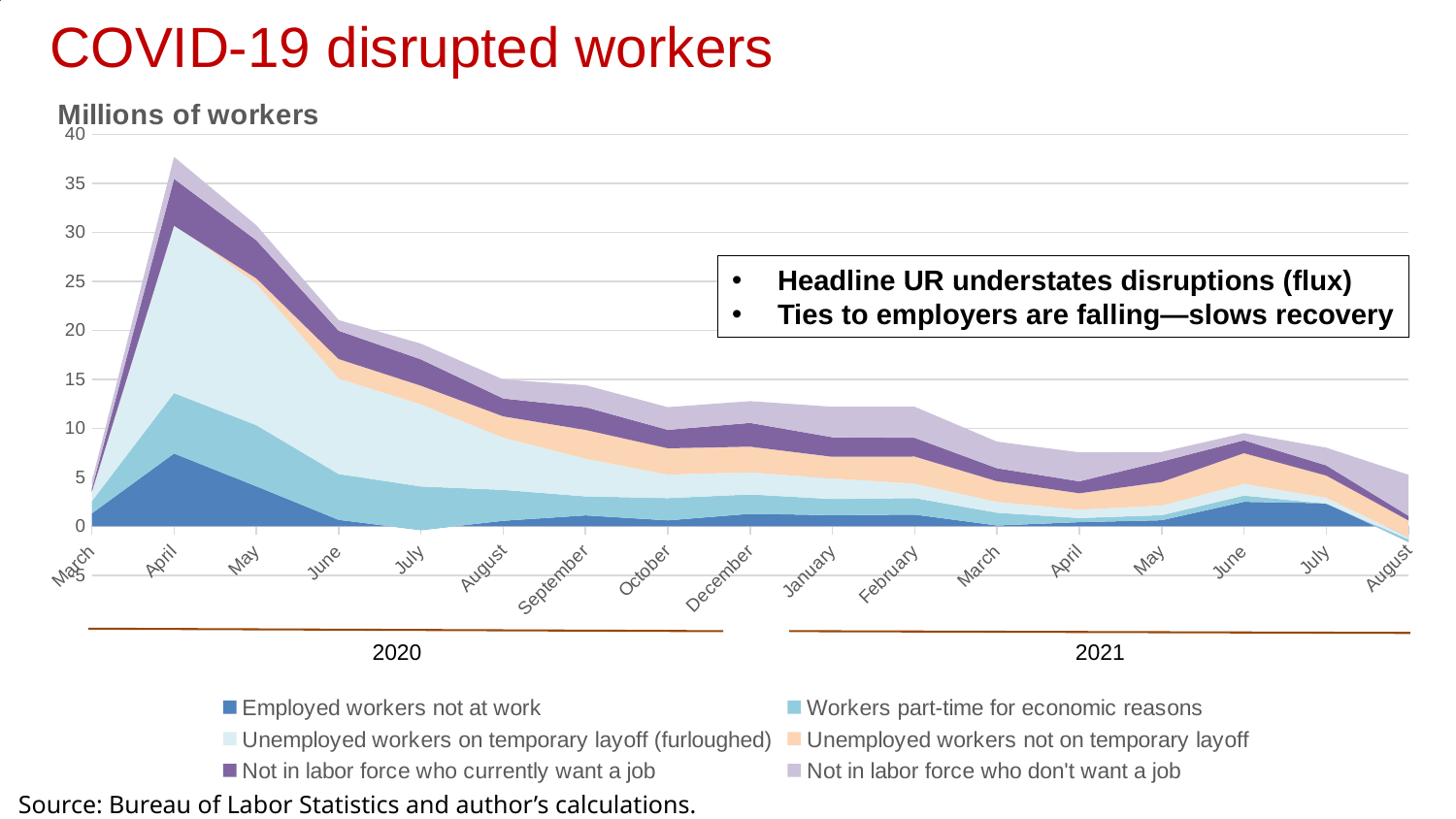
What kind of chart is shown on the slide? Stacked area chart In which month does the total number of disrupted workers reach its highest point? April 2020 Which month has a larger total of disrupted workers, April 2020 or June 2020? April 2020 Is the total number of disrupted workers in April 2020 greater or less than 35 million? greater What is the title of the slide's chart? Millions of workers What unit label is shown above the vertical axis? Millions of workers Is the total number of disrupted workers in March 2020 greater or less than 10 million? less Is the total number of disrupted workers in June 2020 greater or less than 15 million? greater Which month has a larger total of disrupted workers, February 2021 or April 2021? February 2021 From April 2020 to April 2021, does the total number of disrupted workers rise or fall? fall How many series does the legend list? 6